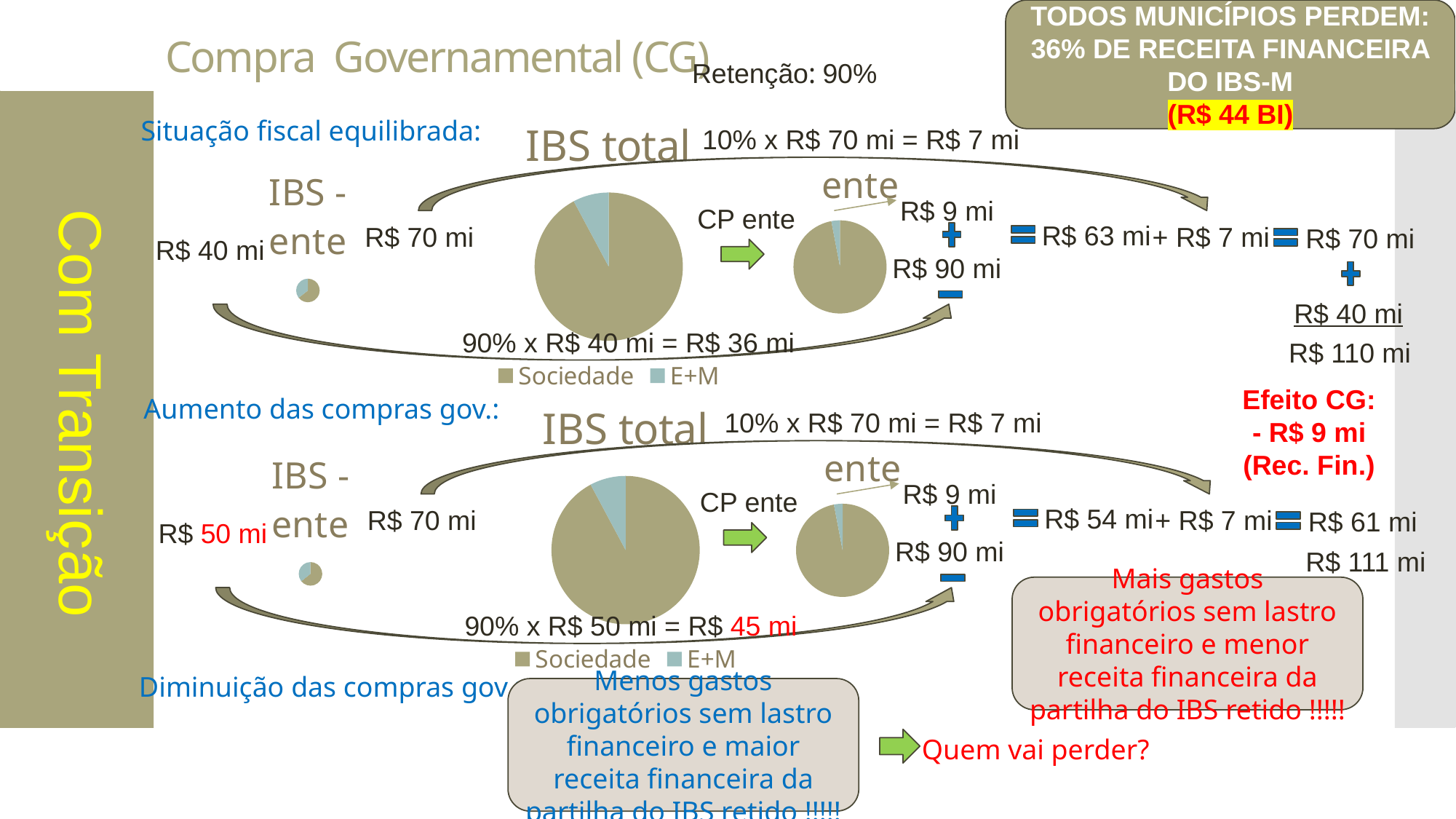
What kind of chart is the small 'IBS - ente' chart in the bottom section? Pie chart How many pie charts are shown on the slide in total? 6 What colour is the Sociedade slice in the 'IBS total' pie charts? Khaki/olive brown What are the two legend entries shown below the 'IBS total' charts? Sociedade and E+M What kind of chart is the top 'IBS total' chart? Pie chart In the top 'IBS total' pie chart, which slice is larger, Sociedade or E+M? Sociedade How many entries does the legend below the top 'IBS total' chart list? 2 In the bottom 'IBS total' pie chart, which category has the smallest slice? E+M In the bottom 'IBS total' pie chart, which category has the largest slice? Sociedade How many slices does the top 'IBS total' pie chart have? 2